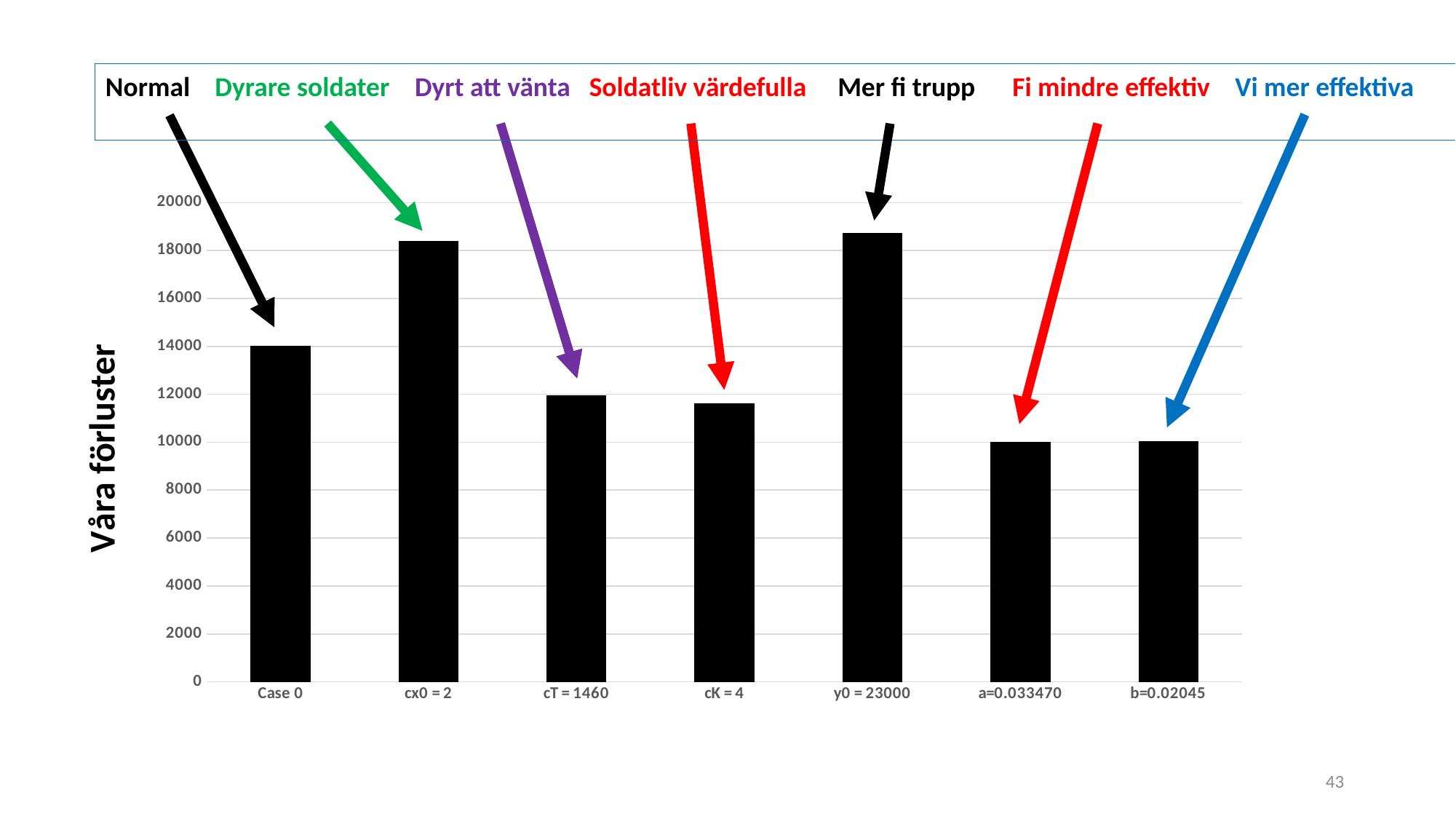
Which is larger, the value for Case 0 or the value for cT = 1460? Case 0 Is the value for cx0 = 2 greater or less than 16000? greater Is the value for cT = 1460 greater or less than 14000? less Is the value for a=0.033470 greater or less than 12000? less How many categories are plotted on the x axis of the chart? 7 Which label does the green arrow pointing at the cx0 = 2 bar come from? Dyrare soldater Which is larger, the value for y0 = 23000 or the value for b=0.02045? y0 = 23000 Which is larger, the value for cx0 = 2 or the value for cK = 4? cx0 = 2 What is the title of the vertical axis of the chart? Våra förluster What kind of chart is shown on the slide? bar chart